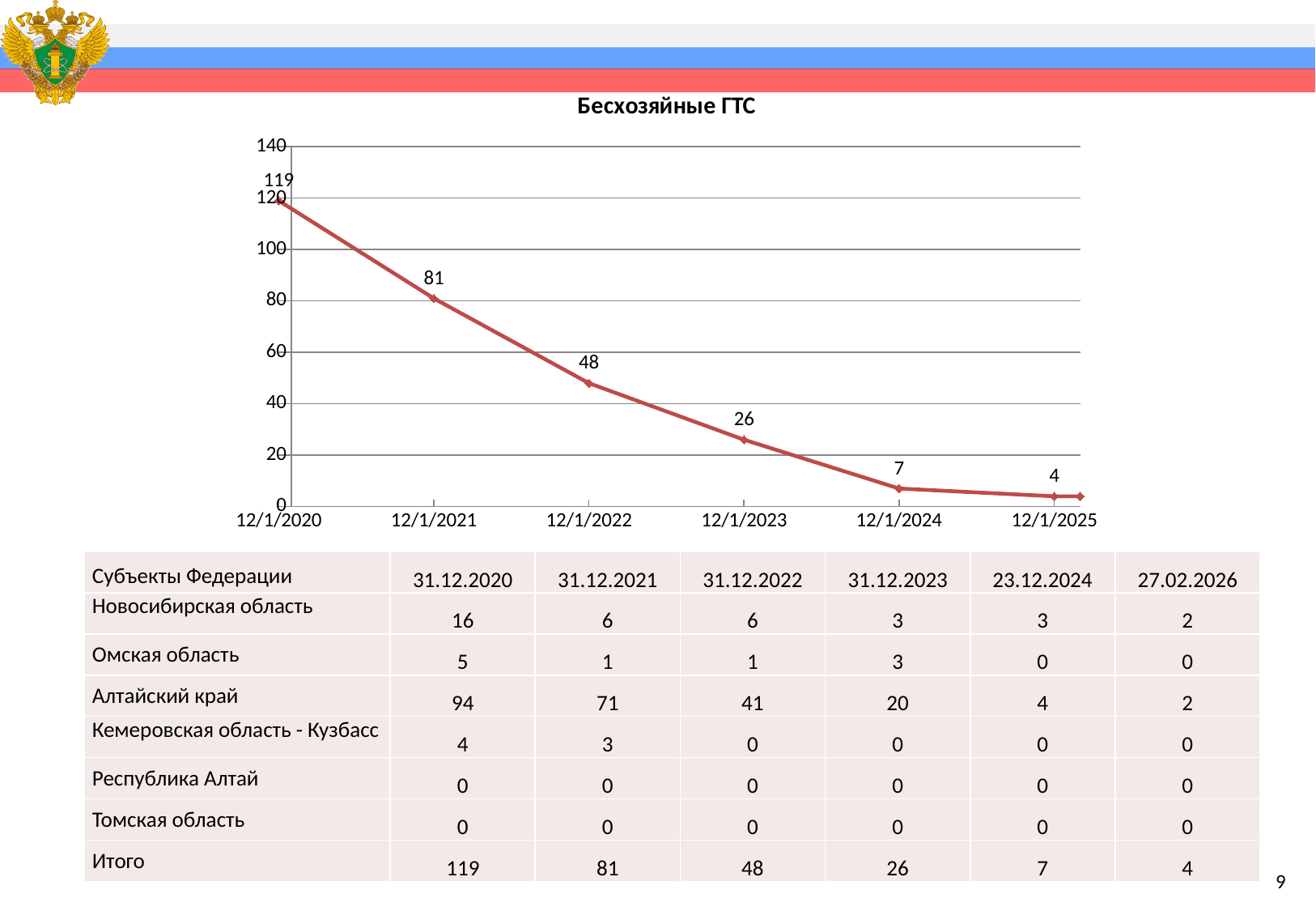
Which date has the highest value in the chart? 12/1/2020 What kind of chart is shown on the slide? line chart What is the value for 12/1/2020 in the chart? 119 What is the difference between the values for 12/1/2020 and 12/1/2021? 38 Which is larger, the value for 12/1/2021 or the value for 12/1/2022? 12/1/2021 What is the difference between the values for 12/1/2022 and 12/1/2023? 22 What is the value for 12/1/2024 in the chart? 7 What is the title of the chart? Бесхозяйные ГТС Do the values rise or fall along the x axis from 12/1/2020 to 12/1/2025? fall What is the value for 12/1/2022 in the chart? 48 What is the value for 12/1/2023 in the chart? 26 What is the value for 12/1/2021 in the chart? 81